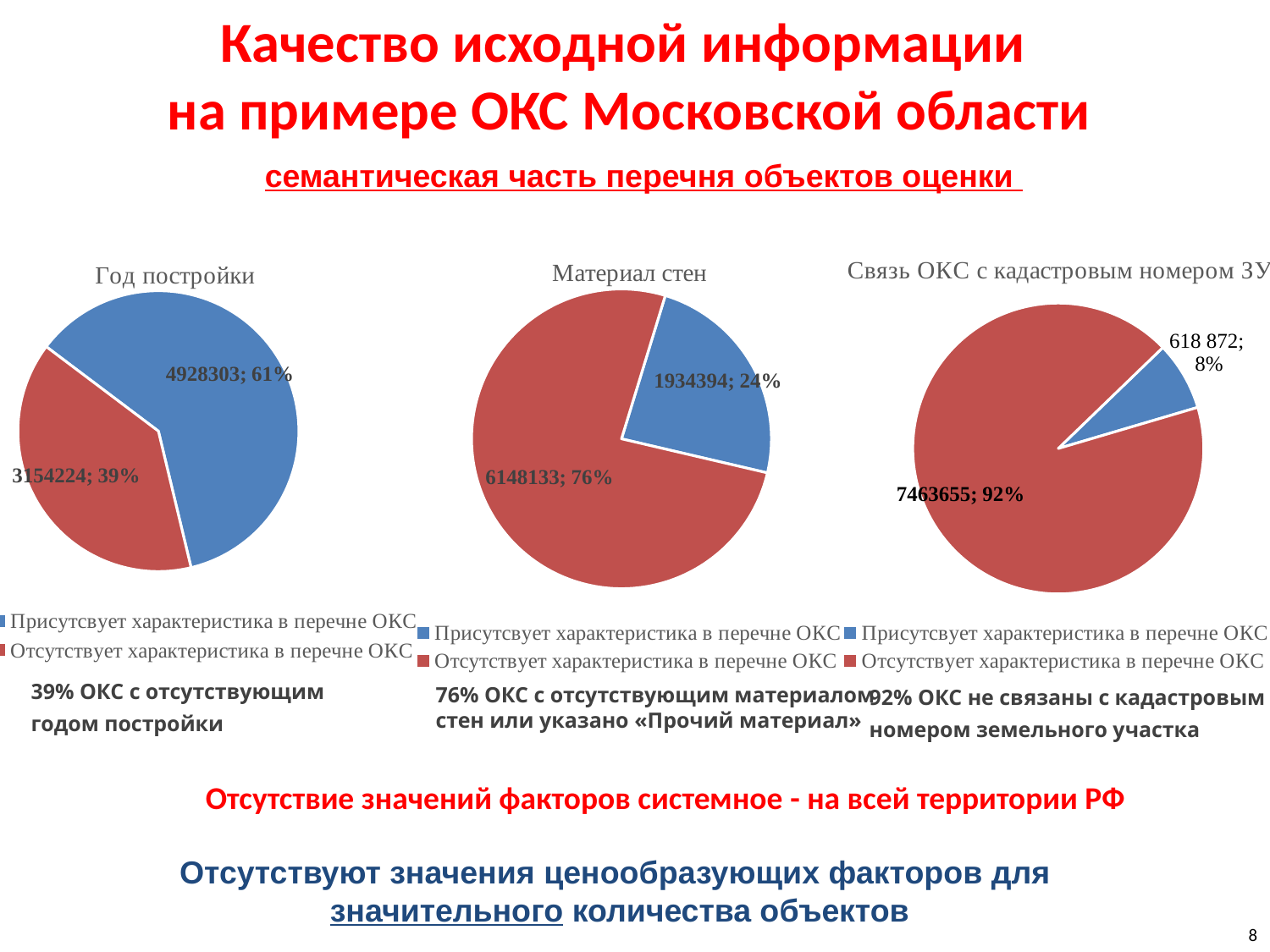
In the 'Год постройки' pie chart, which slice is larger: 'Присутствует характеристика в перечне ОКС' or 'Отсутствует характеристика в перечне ОКС'? Присутствует характеристика в перечне ОКС What type of chart is used for 'Связь ОКС с кадастровым номером ЗУ'? Pie chart In the 'Год постройки' pie chart, what value is shown for the slice 'Присутствует характеристика в перечне ОКС'? 4928303; 61% In the 'Год постройки' pie chart, what is the difference between the two slice values? 1774079 In the 'Связь ОКС с кадастровым номером ЗУ' pie chart, what share of the pie is 'Отсутствует характеристика в перечне ОКС'? 92% In the 'Материал стен' pie chart, what value is shown for 'Отсутствует характеристика в перечне ОКС'? 6148133; 76% In the 'Год постройки' pie chart, what share of the pie is 'Отсутствует характеристика в перечне ОКС'? 39% In the 'Связь ОКС с кадастровым номером ЗУ' pie chart, which slice is the smallest? Присутствует характеристика в перечне ОКС In the 'Материал стен' pie chart, which slice is the largest? Отсутствует характеристика в перечне ОКС In the 'Связь ОКС с кадастровым номером ЗУ' pie chart, what value is shown for 'Присутствует характеристика в перечне ОКС'? 618 872; 8% In the 'Материал стен' pie chart, what share of the pie is 'Присутствует характеристика в перечне ОКС'? 24% How many slices does the 'Материал стен' pie chart have? 2